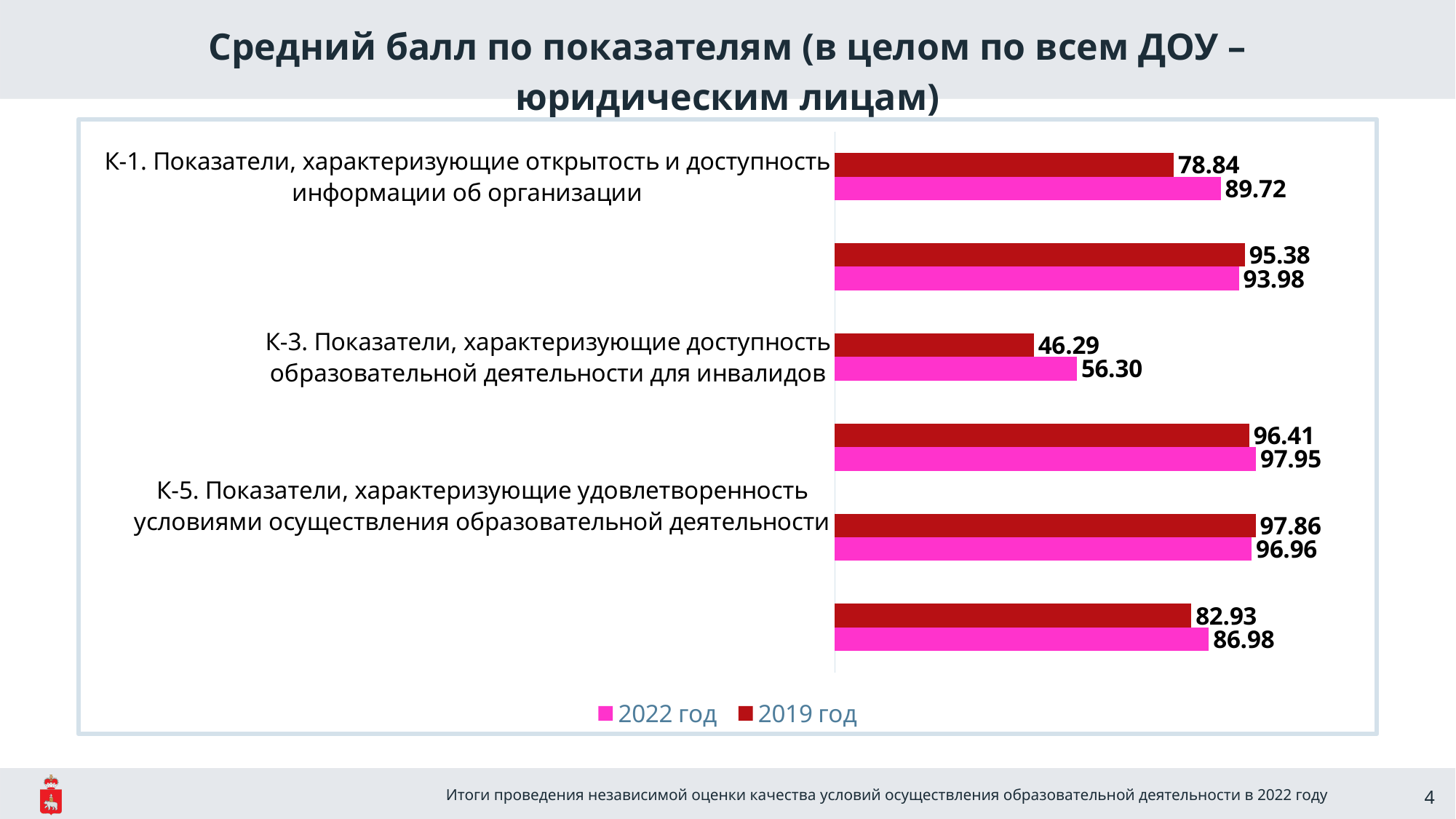
For К-5, which year has the larger value, 2022 год or 2019 год? 2019 год What is the 2019 год value for К-5 (Показатели, характеризующие удовлетворенность условиями осуществления образовательной деятельности)? 97.86 What is the 2019 год value for К-1 (Показатели, характеризующие открытость и доступность информации об организации)? 78.84 How many series does the legend list? 2 What is the difference between the 2022 год and 2019 год values for К-3? 10.01 By how much did the value for К-1 increase from 2019 год to 2022 год? 10.88 What is the 2019 год value for К-3 (Показатели, характеризующие доступность образовательной деятельности для инвалидов)? 46.29 What is the 2022 год value for К-3 (Показатели, характеризующие доступность образовательной деятельности для инвалидов)? 56.30 Which labelled category has the lowest 2022 год value? К-3 What is the 2022 год value for К-1 (Показатели, характеризующие открытость и доступность информации об организации)? 89.72 How many category groups of bars are plotted in the chart? 6 What kind of chart is shown on the slide? Bar chart